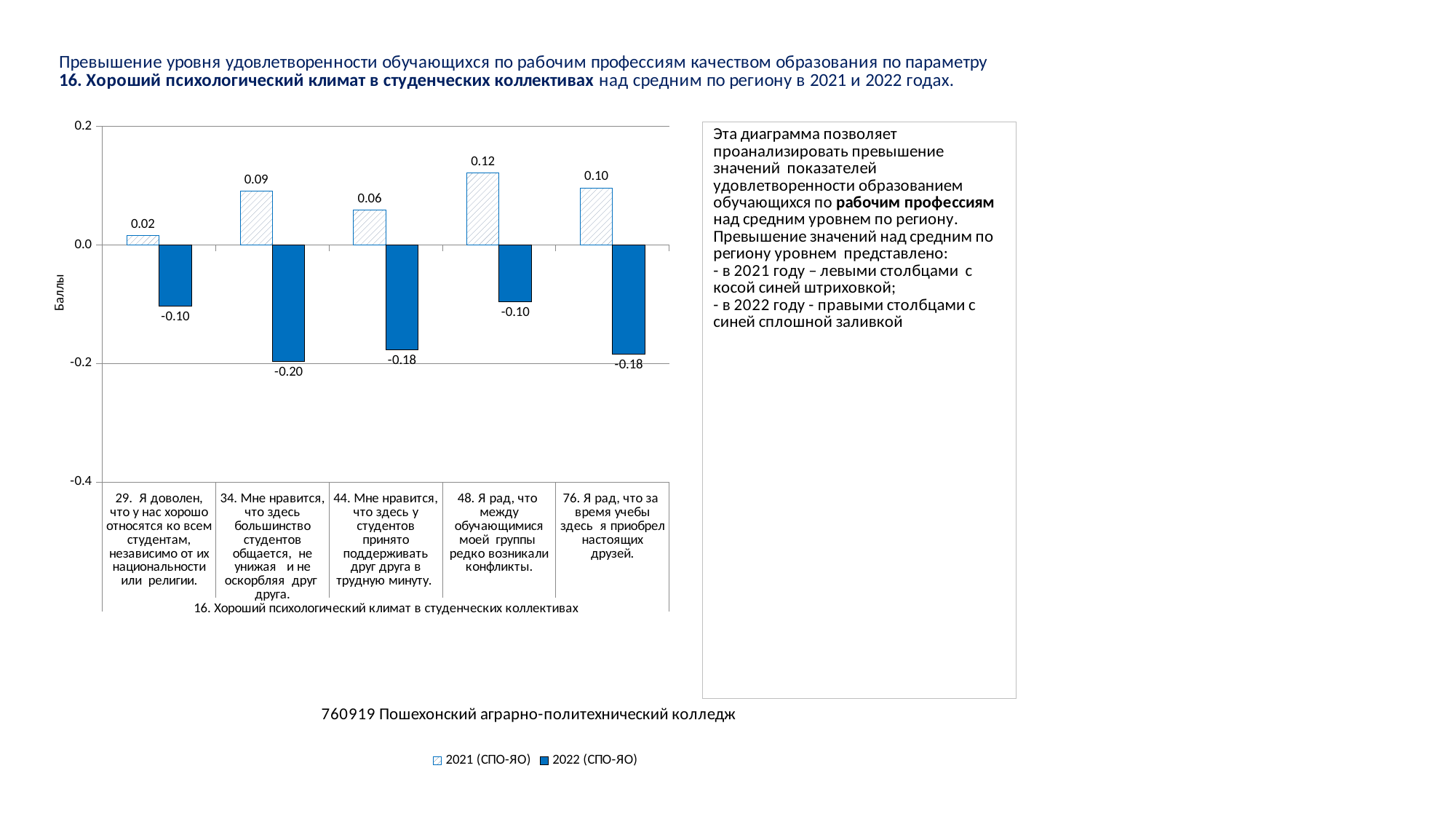
Какого типа эта диаграмма? Столбчатая (bar chart) По какому утверждению значение 2021 (СПО-ЯО) самое высокое? 48. Я рад, что между обучающимися моей группы редко возникали конфликты. Какое значение показано для 2021 (СПО-ЯО) по утверждению «29. Я доволен, что у нас хорошо относятся ко всем студентам, независимо от их национальности или религии»? 0.02 Какое значение 2021 (СПО-ЯО) больше: по утверждению 34 или по утверждению 44? 34. Мне нравится, что здесь большинство студентов общается, не унижая и не оскорбляя друг друга. Какое значение показано для 2022 (СПО-ЯО) по утверждению «76. Я рад, что за время учебы здесь я приобрел настоящих друзей»? -0.18 Сколько утверждений (категорий) показано на диаграмме? 5 На сколько значение 2021 (СПО-ЯО) по утверждению 48 больше значения 2022 (СПО-ЯО) по этому же утверждению? 0.22 Сколько рядов данных указано в легенде диаграммы? 2 По какому утверждению значение 2022 (СПО-ЯО) самое низкое? 34. Мне нравится, что здесь большинство студентов общается, не унижая и не оскорбляя друг друга. Какое значение показано для 2021 (СПО-ЯО) по утверждению «48. Я рад, что между обучающимися моей группы редко возникали конфликты»? 0.12 Как подписана вертикальная ось диаграммы? Баллы Какое значение показано для 2022 (СПО-ЯО) по утверждению «34. Мне нравится, что здесь большинство студентов общается, не унижая и не оскорбляя друг друга»? -0.20